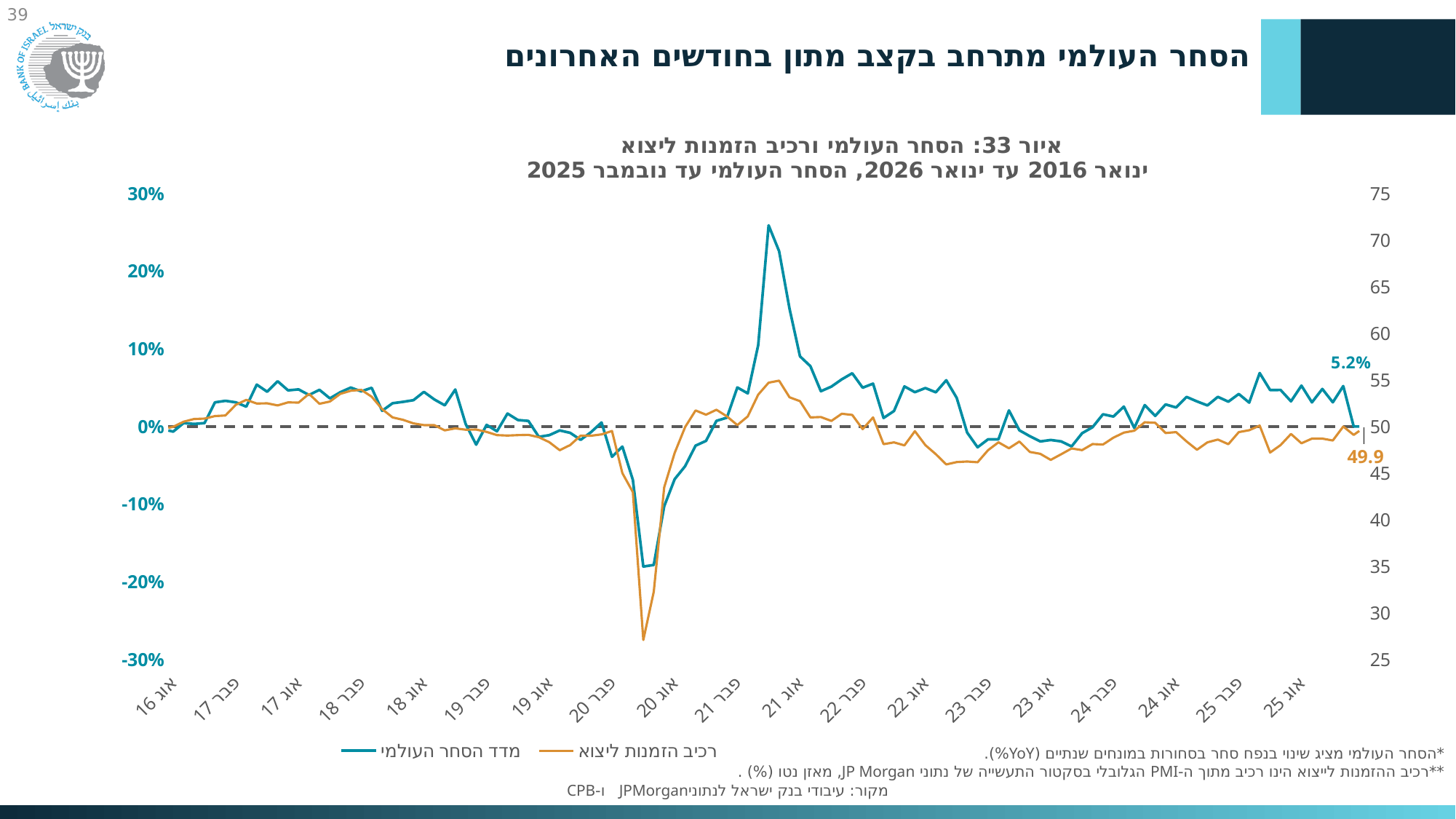
What type of chart is shown on the slide? line chart Is the peak of the world trade index around August 2021 greater or less than 20%? greater Is the lowest point of the export orders component in 2020 greater or less than 30? less Is the value of the world trade index around August 2017 greater or less than 10%? less What is the latest labelled value of the export orders component (רכיב הזמנות ליצוא)? 49.9 How many series does the legend list? 2 At what level on the left axis is the dashed horizontal line drawn? 0% What are the two series named in the legend? מדד הסחר העולמי and רכיב הזמנות ליצוא What is the latest labelled value of the world trade index (מדד הסחר העולמי)? 5.2% Between August 2021 and February 2023, does the world trade index generally rise or fall? fall